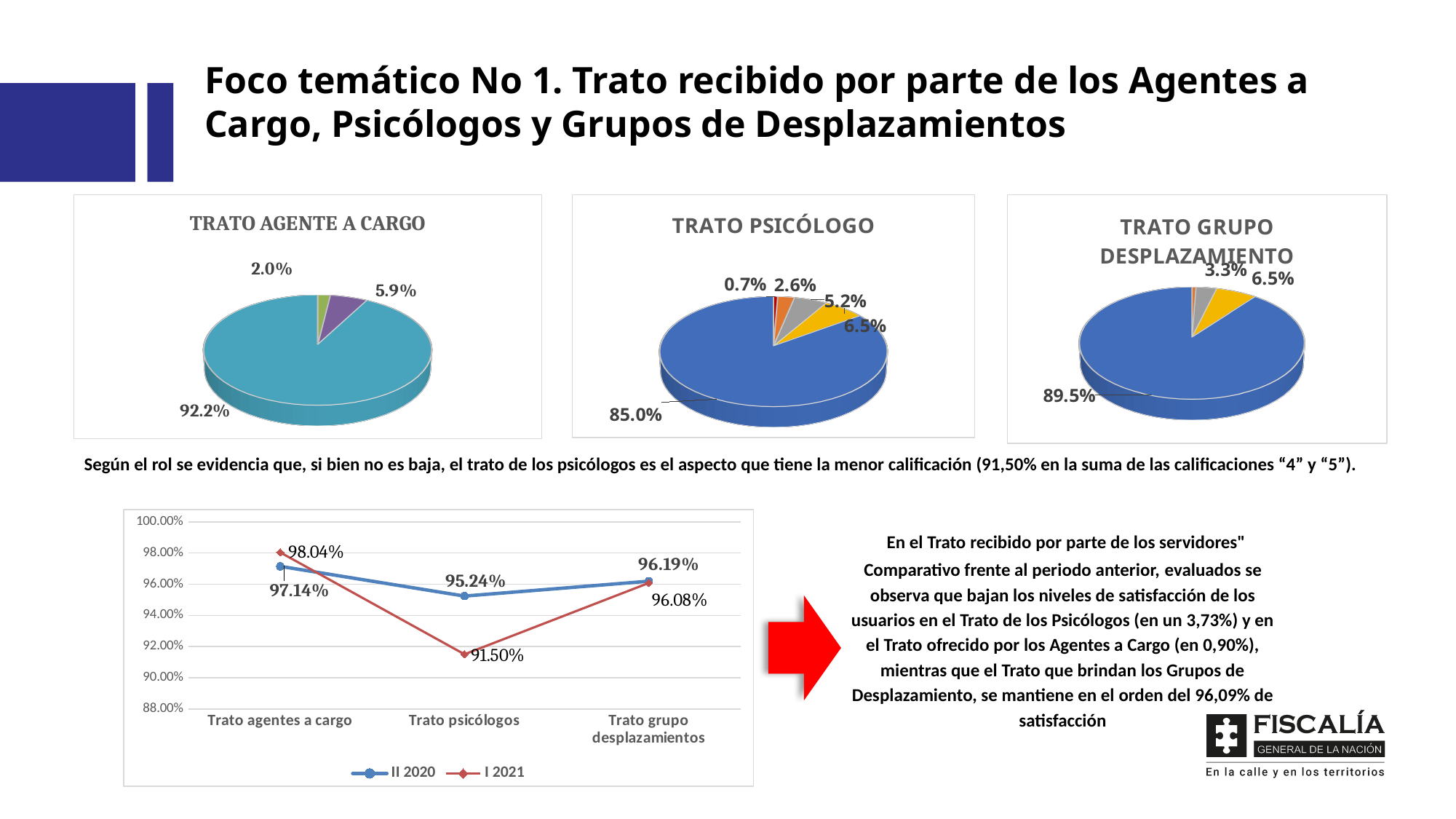
In the pie chart titled TRATO PSICÓLOGO, what is the value of the largest slice? 85.0% In the line chart at the bottom left, what is the value of the I 2021 series for Trato agentes a cargo? 98.04% In the line chart at the bottom left, which category has the lowest value for the I 2021 series? Trato psicólogos In the line chart at the bottom left, does the I 2021 series rise or fall from Trato agentes a cargo to Trato psicólogos? Fall In the line chart at the bottom left, what is the difference between the I 2021 and II 2020 values for Trato agentes a cargo? 0.90% In the line chart at the bottom left, how many series does the legend list? 2 In the pie chart titled TRATO AGENTE A CARGO, how many slices are there? 3 In the line chart at the bottom left, what is the value of the II 2020 series for Trato psicólogos? 95.24% What kind of chart is the chart at the bottom left of the slide? Line chart In the line chart at the bottom left, which series has the larger value for Trato grupo desplazamientos, II 2020 or I 2021? II 2020 In the line chart at the bottom left, how many categories are shown on the x axis? 3 In the pie chart titled TRATO GRUPO DESPLAZAMIENTO, what is the value of the largest slice? 89.5%